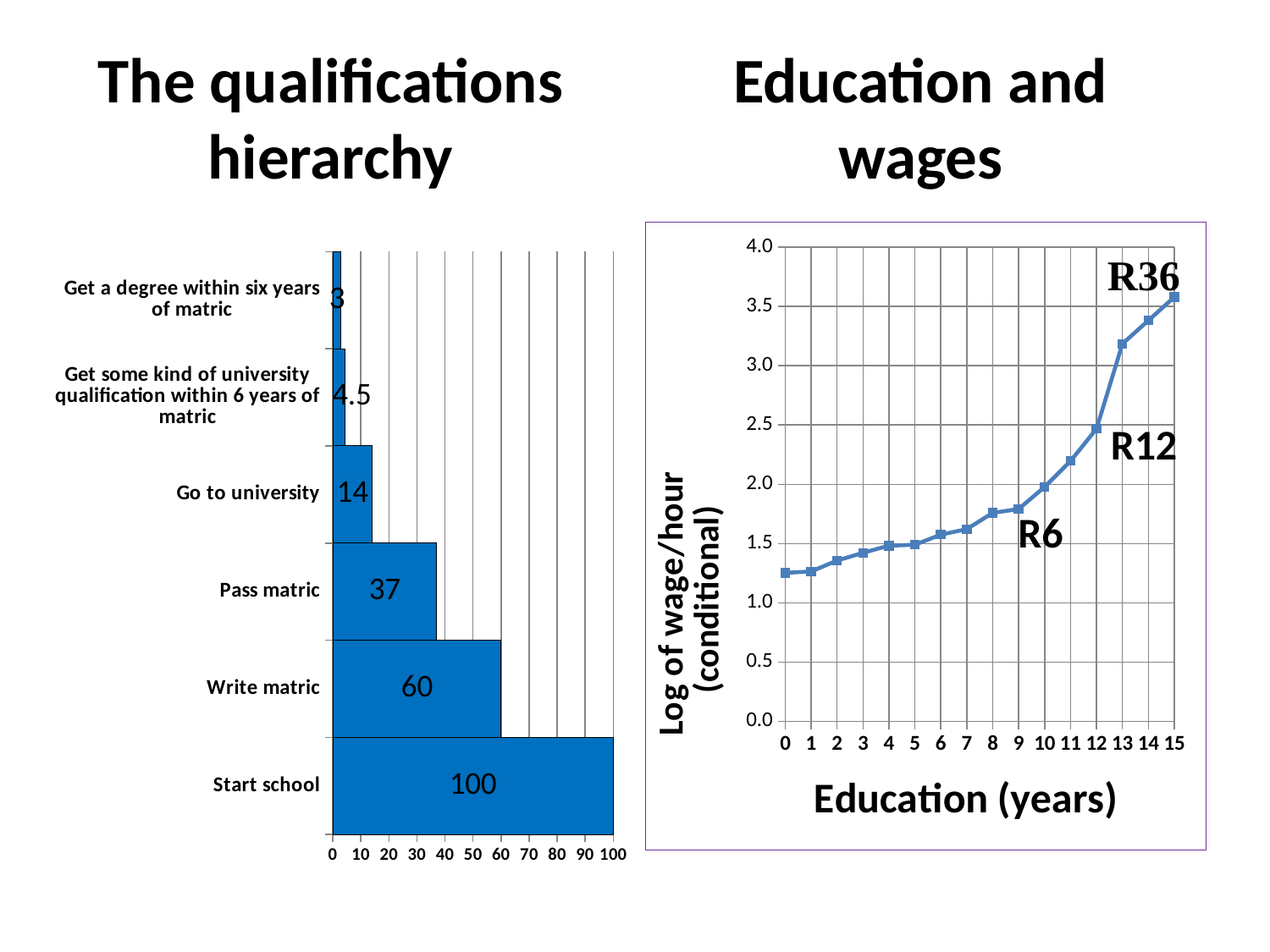
In the qualifications hierarchy chart, which category has the lowest value? Get a degree within six years of matric In the Education and wages chart, is the value at 0 years of education greater or less than 1.5? less In the Education and wages chart, do the values rise or fall as years of education increase? Rise In the qualifications hierarchy chart, what is the value for Get some kind of university qualification within 6 years of matric? 4.5 In the qualifications hierarchy chart, which is larger, the value for Go to university or the value for Pass matric? Pass matric In the Education and wages chart, is the value at 13 years of education greater or less than 3.0? greater In the qualifications hierarchy chart, what is the value for Pass matric? 37 In the qualifications hierarchy chart, what is the value for Go to university? 14 In the qualifications hierarchy chart, what is the difference between the values for Write matric and Pass matric? 23 In the qualifications hierarchy chart, which category has the highest value? Start school What kind of chart is the qualifications hierarchy chart? Bar chart How many categories does the qualifications hierarchy chart show? 6